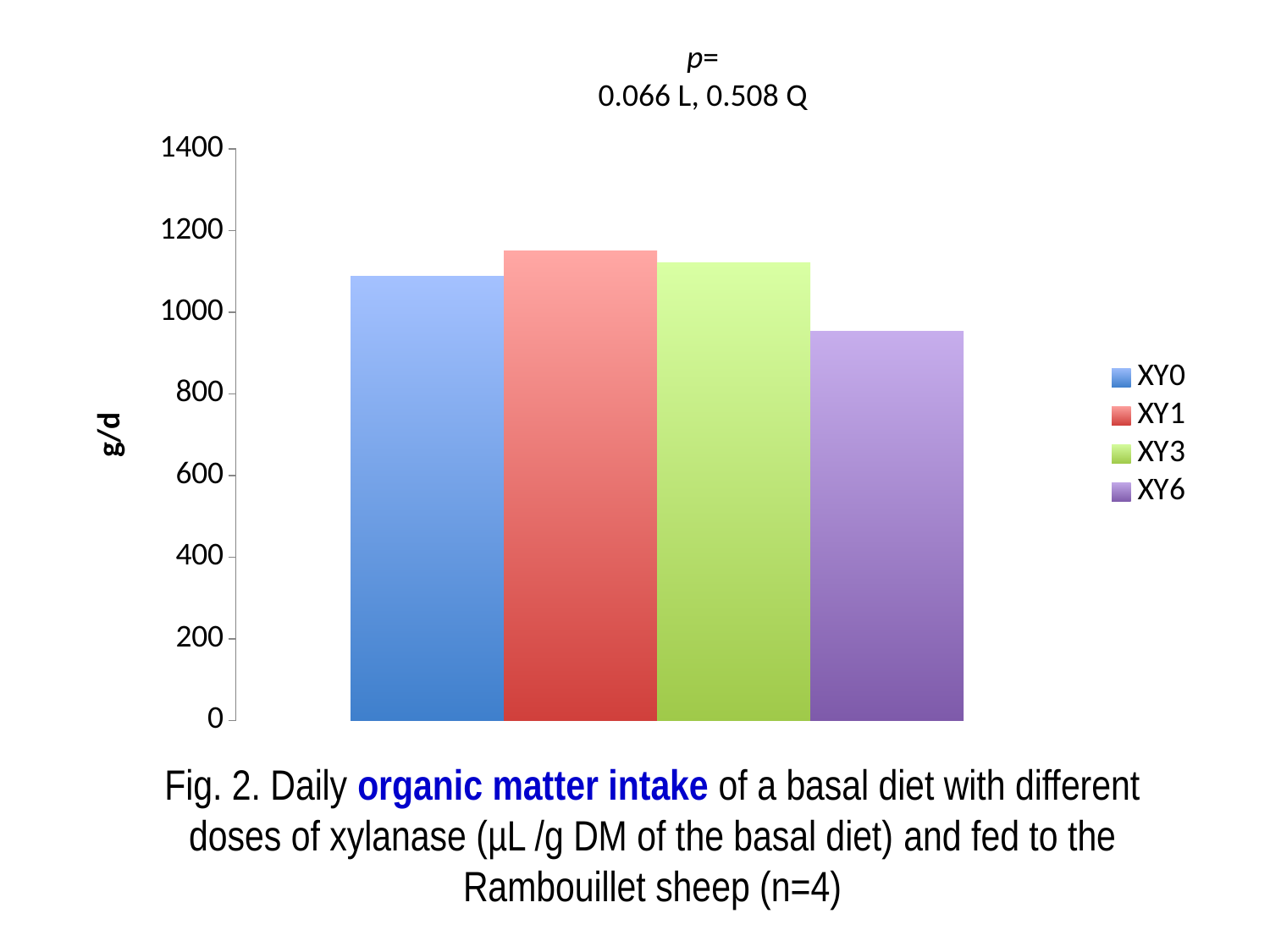
How many series does the legend list? 4 Is the value for XY0 greater or less than 1000? greater What is the label on the y axis of the chart? g/d Which is larger, the value for XY1 or the value for XY6? XY1 What kind of chart is shown on the slide? bar chart Is the value for XY6 greater or less than 1000? less What colour is the bar for XY3 in the chart? green Is the value for XY6 greater or less than 800? greater Which series has the lowest daily organic matter intake? XY6 How many bars are plotted in the chart? 4 Which is larger, the value for XY0 or the value for XY6? XY0